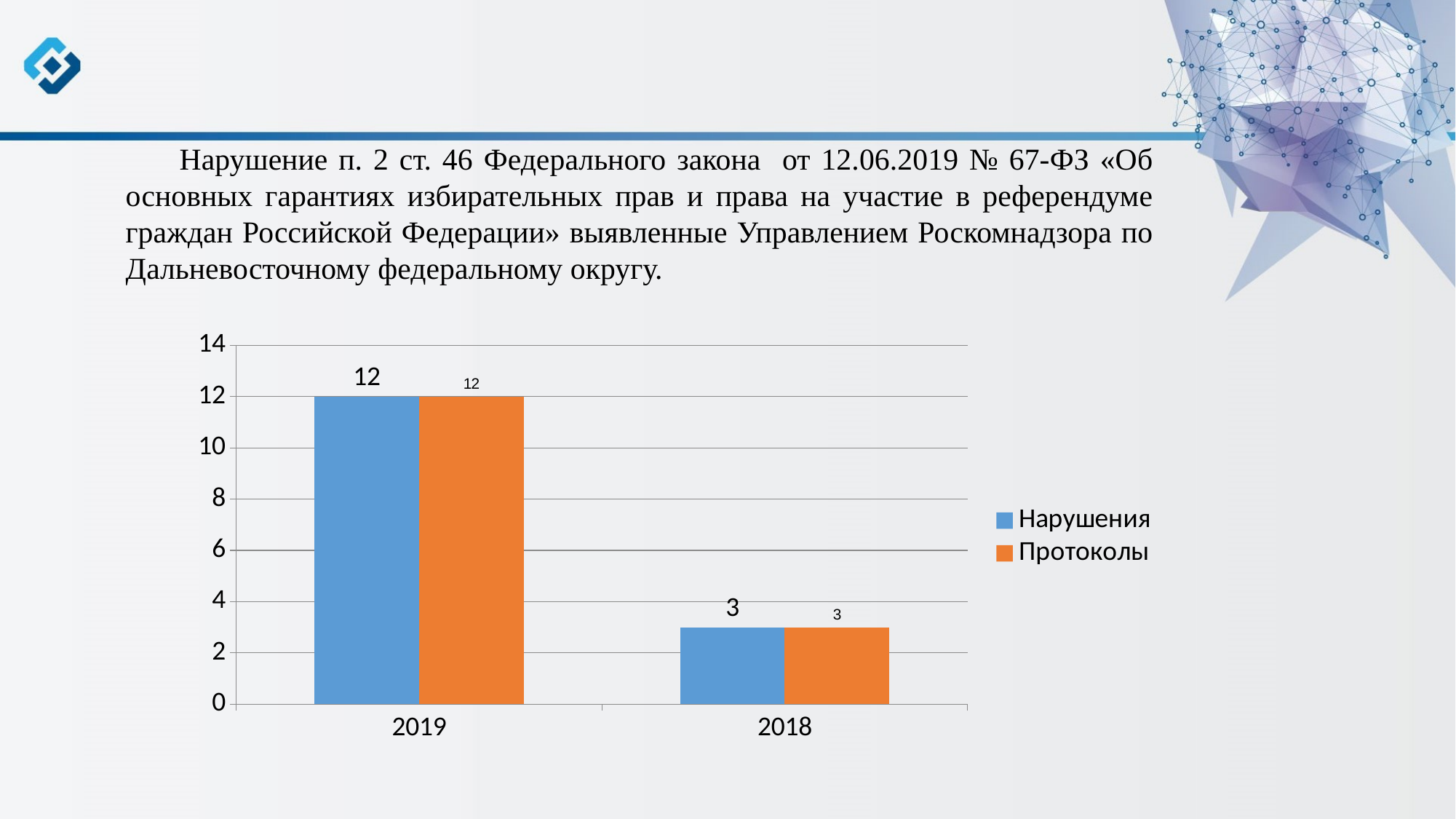
What is the value of Нарушения for 2019? 12 How many categories are shown on the x axis? 2 What is the value of Протоколы for 2018? 3 Which year has the higher value for Нарушения? 2019 What is the difference between the Нарушения values for 2019 and 2018? 9 Is the value of Протоколы for 2019 larger or smaller than the value of Протоколы for 2018? larger Is the value of Нарушения for 2019 greater or less than 10? greater How many series does the legend list? 2 What is the value of Протоколы for 2019? 12 What is the value of Нарушения for 2018? 3 Which year has the lowest value for Протоколы? 2018 What type of chart is shown on the slide? bar chart